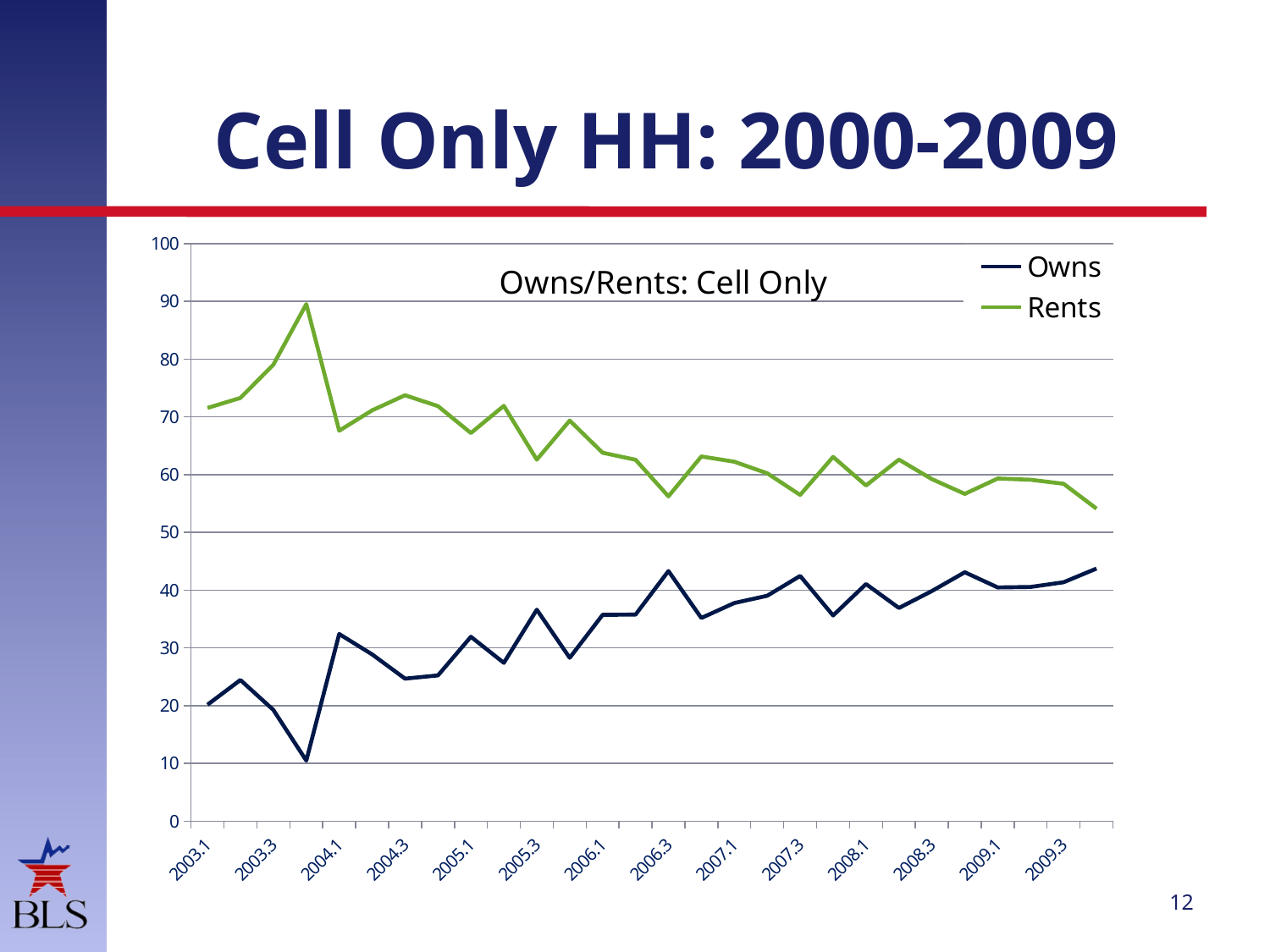
How many series does the legend list? 2 Is the value for Rents at 2003.1 greater or less than 60? greater Which series reaches the highest value anywhere on the chart? Rents Is the value for Owns at 2003.1 greater or less than 30? less Which series is drawn in green? Rents Which series has the higher value at 2003.1, Owns or Rents? Rents What kind of chart is shown on the slide? line chart Does the Owns series generally rise or fall from 2003.1 to 2009.3? rise Does the Rents series generally rise or fall from 2003.1 to 2009.3? fall What is the title of the chart? Owns/Rents: Cell Only Is the value for Rents at 2009.3 greater or less than 50? greater